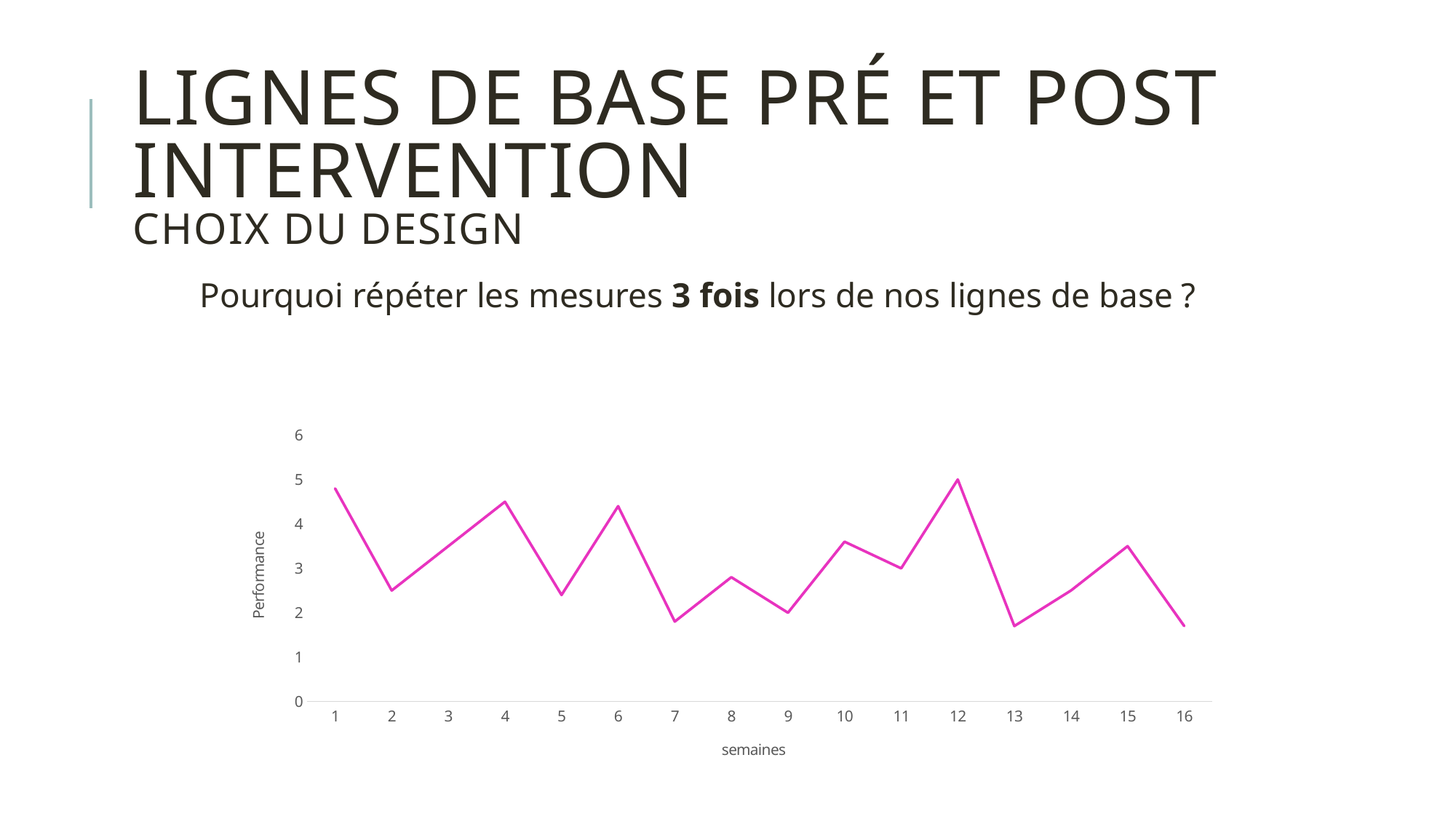
How many weeks (points) are plotted on the x axis? 16 Which is larger, the value for week 1 or the value for week 2? week 1 Which is larger, the value for week 12 or the value for week 13? week 12 Is the value for week 7 greater or less than 2? less What kind of chart is shown on the slide? line chart Is the value for week 1 greater or less than 4? greater Is the value for week 13 greater or less than 2? less What is the label of the y axis? Performance What is the label of the x axis? semaines